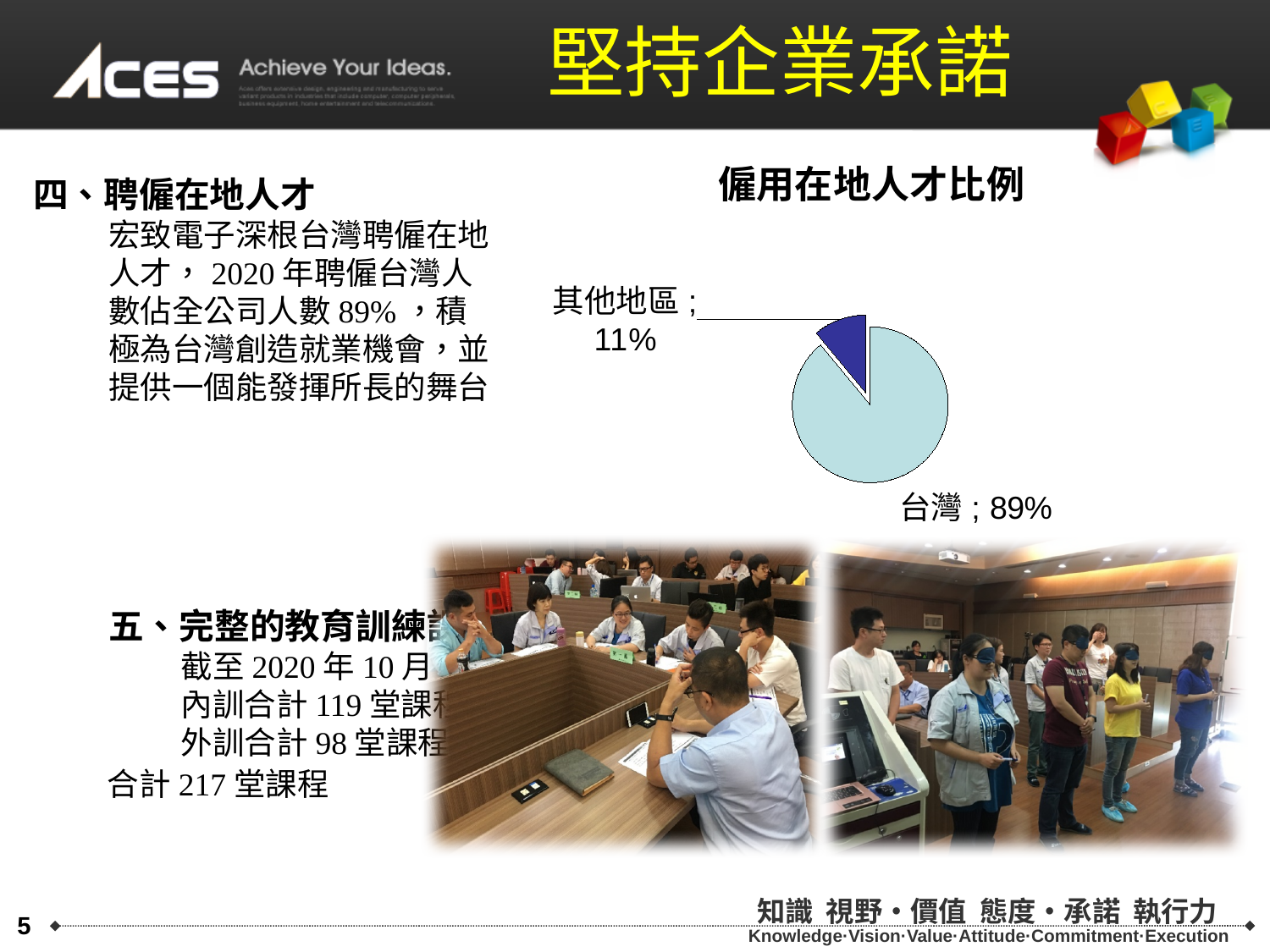
Is the share for 其他地區 greater or less than 50%? less What share of the pie does 台灣 represent? 89% What colour is the 台灣 slice of the pie chart? light blue What is the title of the chart on the slide? 僱用在地人才比例 How many slices does the pie chart have? 2 Which slice of the pie chart is the largest? 台灣 Which slice of the pie chart is the smallest? 其他地區 Which is larger in the pie chart, 台灣 or 其他地區? 台灣 What is the difference in percentage points between the 台灣 slice and the 其他地區 slice? 78 What share of the pie does 其他地區 represent? 11% What type of chart is shown under the title 僱用在地人才比例? pie chart